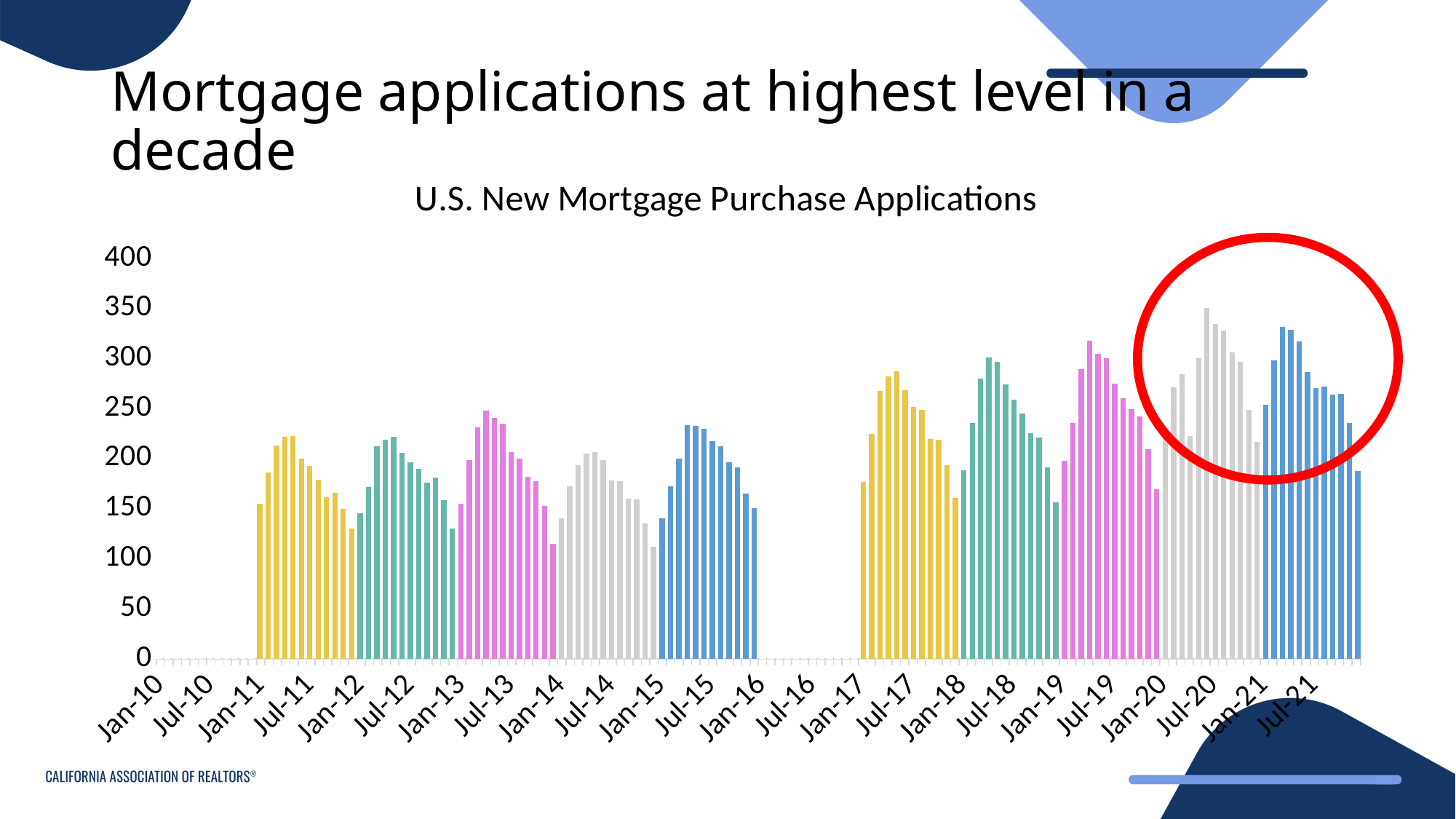
Is the value for Jul-15 greater or less than 200? greater Is the value for Jul-20 greater or less than 300? greater What is the highest value shown on the vertical axis? 400 Is the value for Jan-17 greater or less than 200? less What kind of chart is shown on the slide? bar chart Do the values rise or fall from Jul-20 to Jan-21? fall What is the title of the chart? U.S. New Mortgage Purchase Applications Which is larger, the value for Jan-14 or the value for Jul-15? Jul-15 Which is larger, the value for Jul-20 or the value for Jan-11? Jul-20